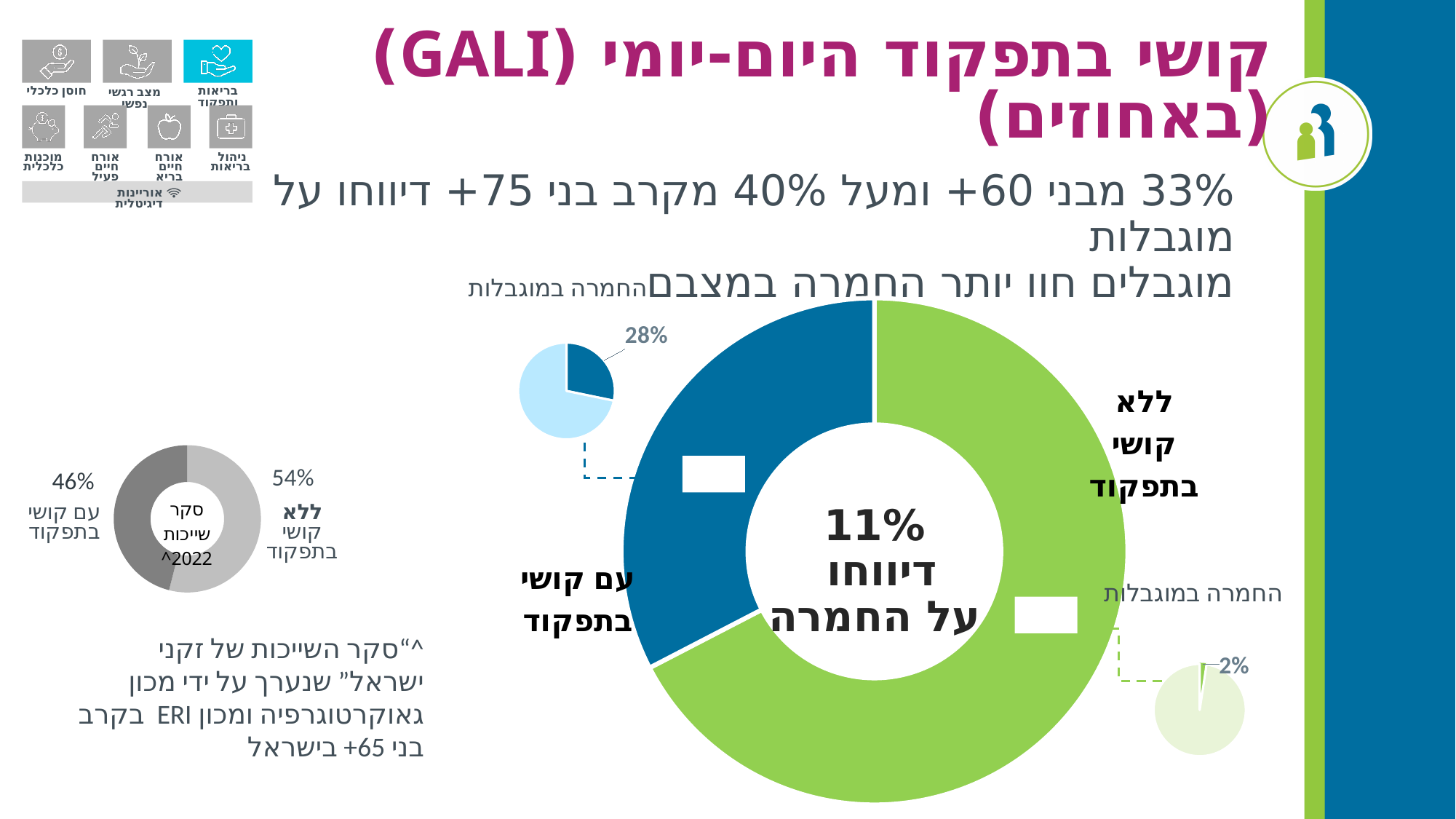
What kind of chart is the large chart in the centre of the slide? Donut chart How many slices does the small donut chart on the left (סקר שייכות 2022) have? 2 In the small pie chart at the top left of the large donut (linked to עם קושי בתפקוד), what percentage is labelled for החמרה במוגבלות? 28% What is the difference in percentage points between the החמרה במוגבלות shares in the two small pie charts (28% and 2%)? 26 Which small pie chart shows a larger share for החמרה במוגבלות: the one linked to עם קושי בתפקוד or the one linked to ללא קושי בתפקוד? עם קושי בתפקוד In the small donut chart on the left (סקר שייכות 2022), what percentage is shown for ללא קושי בתפקוד (without functional difficulty)? 54% In the small pie chart at the bottom right of the large donut (linked to ללא קושי בתפקוד), what percentage is labelled for החמרה במוגבלות? 2% In the small donut chart on the left (סקר שייכות 2022), what percentage is shown for עם קושי בתפקוד (with functional difficulty)? 46% In the small donut chart on the left (סקר שייכות 2022), what is the difference in percentage points between ללא קושי בתפקוד and עם קושי בתפקוד? 8 What percentage is printed in the centre of the large donut chart? 11% In the large donut chart, which colour represents ללא קושי בתפקוד? Green In the small donut chart on the left (סקר שייכות 2022), which category has the larger share? ללא קושי בתפקוד